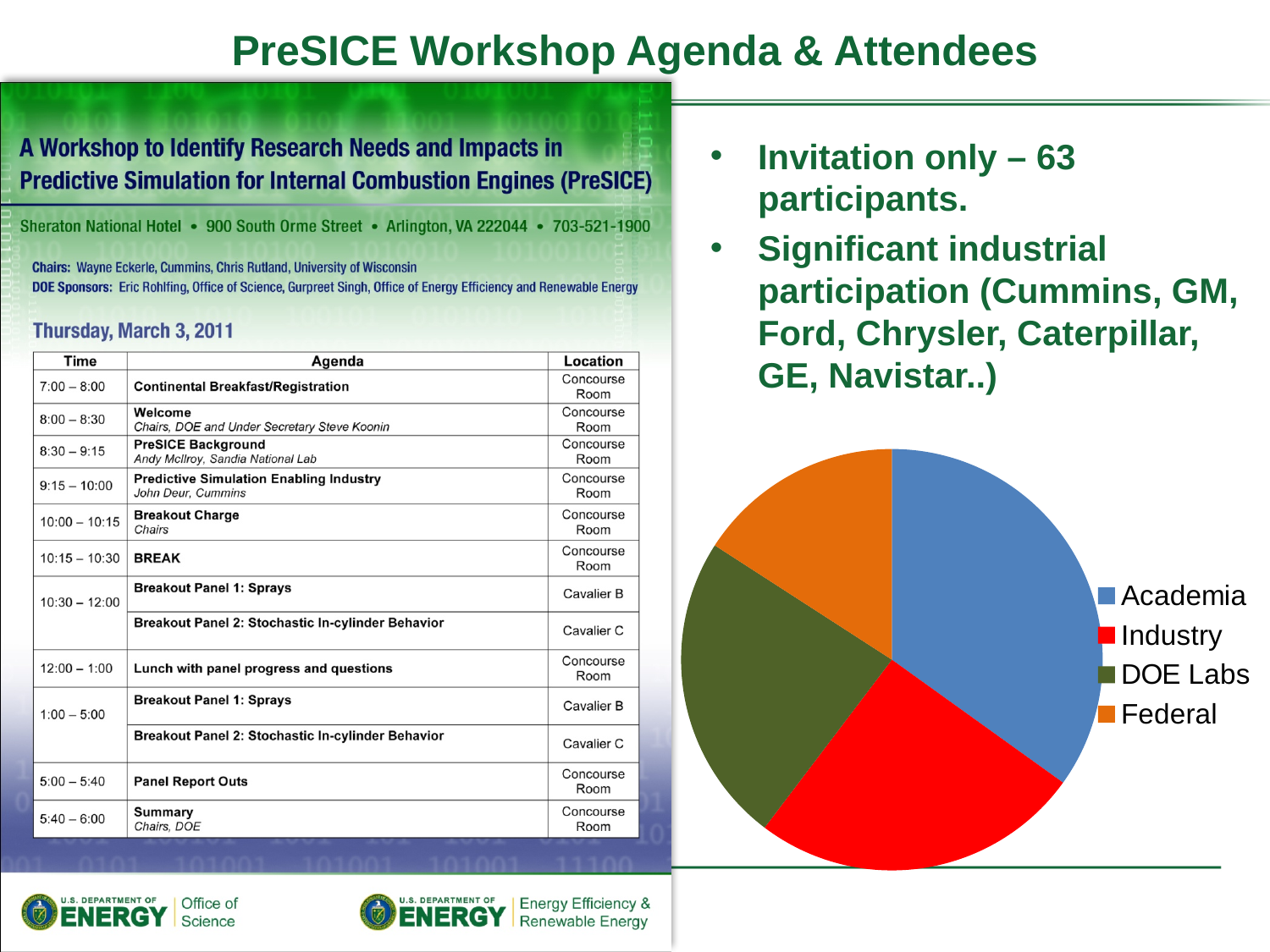
How many slices does the pie chart have? 4 How many entries does the pie chart's legend list? 4 Which slice is larger in the pie chart, Academia or Federal? Academia Which category is shown in orange in the pie chart? Federal What colour represents Industry in the pie chart? red What kind of chart is shown on the slide? pie chart Which slice is larger in the pie chart, Academia or Industry? Academia Which category has the smallest slice of the pie chart? Federal Which slice is larger in the pie chart, DOE Labs or Federal? DOE Labs Which category has the largest slice of the pie chart? Academia